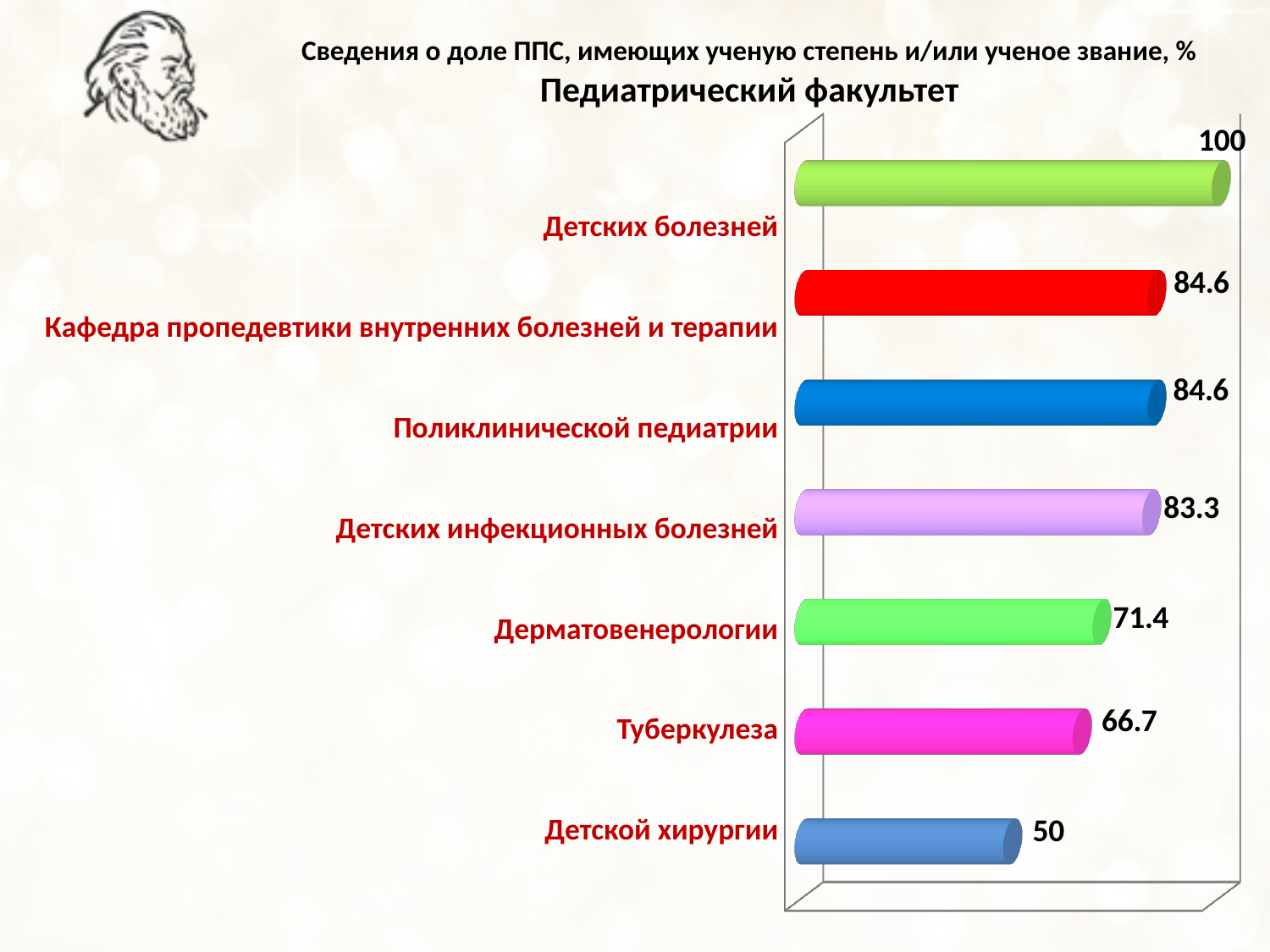
What kind of chart is shown on the slide? Bar chart What is the value for Детских инфекционных болезней? 83.3 What is the difference between the values for Дерматовенерологии and Туберкулеза? 4.7 What is the difference between the values for Детских болезней and Детской хирургии? 50 What is the value for Дерматовенерологии? 71.4 Which category has the highest value? Детских болезней What is the value for Детской хирургии? 50 How many categories are shown in the chart? 7 What is the value for Детских болезней? 100 What is the subtitle of the chart, shown below the main title? Педиатрический факультет Which is larger, the value for Туберкулеза or the value for Детской хирургии? Туберкулеза Which category has the lowest value? Детской хирургии